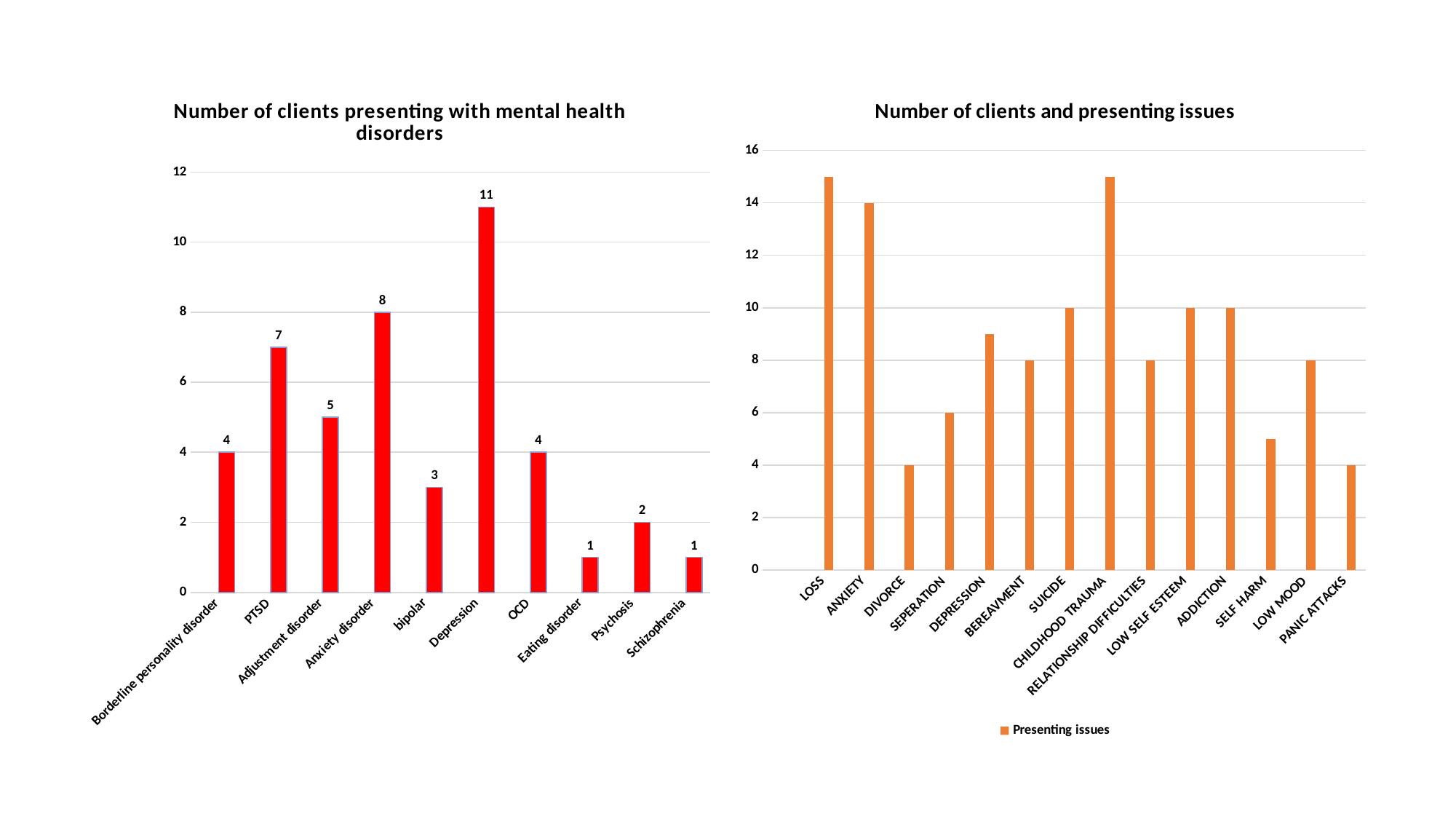
In the chart 'Number of clients and presenting issues', what is the value for SEPERATION? 6 In the chart 'Number of clients and presenting issues', is the value for LOSS greater or less than 14? greater In the chart 'Number of clients and presenting issues', what is the value for ANXIETY? 14 How many categories are shown in the chart 'Number of clients presenting with mental health disorders'? 10 In the chart 'Number of clients presenting with mental health disorders', which disorder has the highest number of clients? Depression What series name does the legend of the chart 'Number of clients and presenting issues' show? Presenting issues In the chart 'Number of clients presenting with mental health disorders', what is the difference between the values for Anxiety disorder and bipolar? 5 In the chart 'Number of clients presenting with mental health disorders', how many clients presented with Depression? 11 How many categories are shown in the chart 'Number of clients and presenting issues'? 14 In the chart 'Number of clients presenting with mental health disorders', what is the value for PTSD? 7 What kind of chart is 'Number of clients and presenting issues'? Bar chart In the chart 'Number of clients presenting with mental health disorders', which is larger, the value for Adjustment disorder or the value for OCD? Adjustment disorder